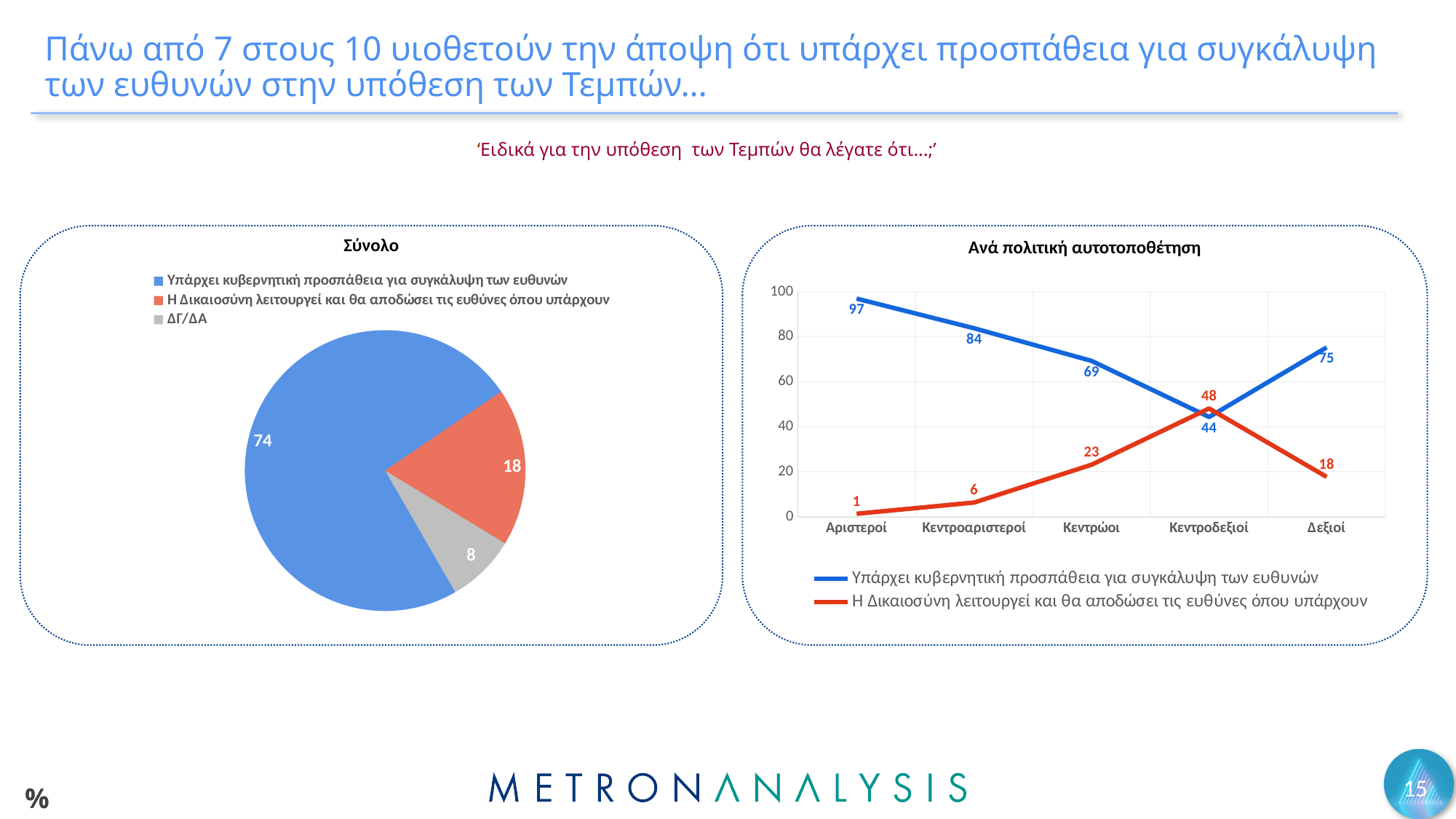
In the 'Σύνολο' pie chart, what is the value for 'Υπάρχει κυβερνητική προσπάθεια για συγκάλυψη των ευθυνών'? 74 In the 'Ανά πολιτική αυτοτοποθέτηση' chart, how many series does the legend list? 2 In the 'Ανά πολιτική αυτοτοποθέτηση' chart, for 'Κεντροδεξιοί', which series has the larger value? Η Δικαιοσύνη λειτουργεί και θα αποδώσει τις ευθύνες όπου υπάρχουν In the 'Ανά πολιτική αυτοτοποθέτηση' chart, does the series 'Η Δικαιοσύνη λειτουργεί και θα αποδώσει τις ευθύνες όπου υπάρχουν' rise or fall from 'Αριστεροί' to 'Κεντροδεξιοί'? Rise In the 'Σύνολο' pie chart, what is the value for 'ΔΓ/ΔΑ'? 8 In the 'Ανά πολιτική αυτοτοποθέτηση' chart, which category has the highest value for 'Υπάρχει κυβερνητική προσπάθεια για συγκάλυψη των ευθυνών'? Αριστεροί In the 'Σύνολο' pie chart, how many slices are there? 3 In the 'Σύνολο' pie chart, which category has the smallest slice? ΔΓ/ΔΑ What kind of chart is the 'Σύνολο' chart on the left? Pie chart In the 'Ανά πολιτική αυτοτοποθέτηση' chart, what is the value for 'Δεξιοί' in the series 'Η Δικαιοσύνη λειτουργεί και θα αποδώσει τις ευθύνες όπου υπάρχουν'? 18 In the 'Ανά πολιτική αυτοτοποθέτηση' chart, what is the difference between 'Αριστεροί' and 'Κεντροαριστεροί' in the series 'Υπάρχει κυβερνητική προσπάθεια για συγκάλυψη των ευθυνών'? 13 In the 'Ανά πολιτική αυτοτοποθέτηση' chart, what is the value for 'Κεντρώοι' in the series 'Υπάρχει κυβερνητική προσπάθεια για συγκάλυψη των ευθυνών'? 69